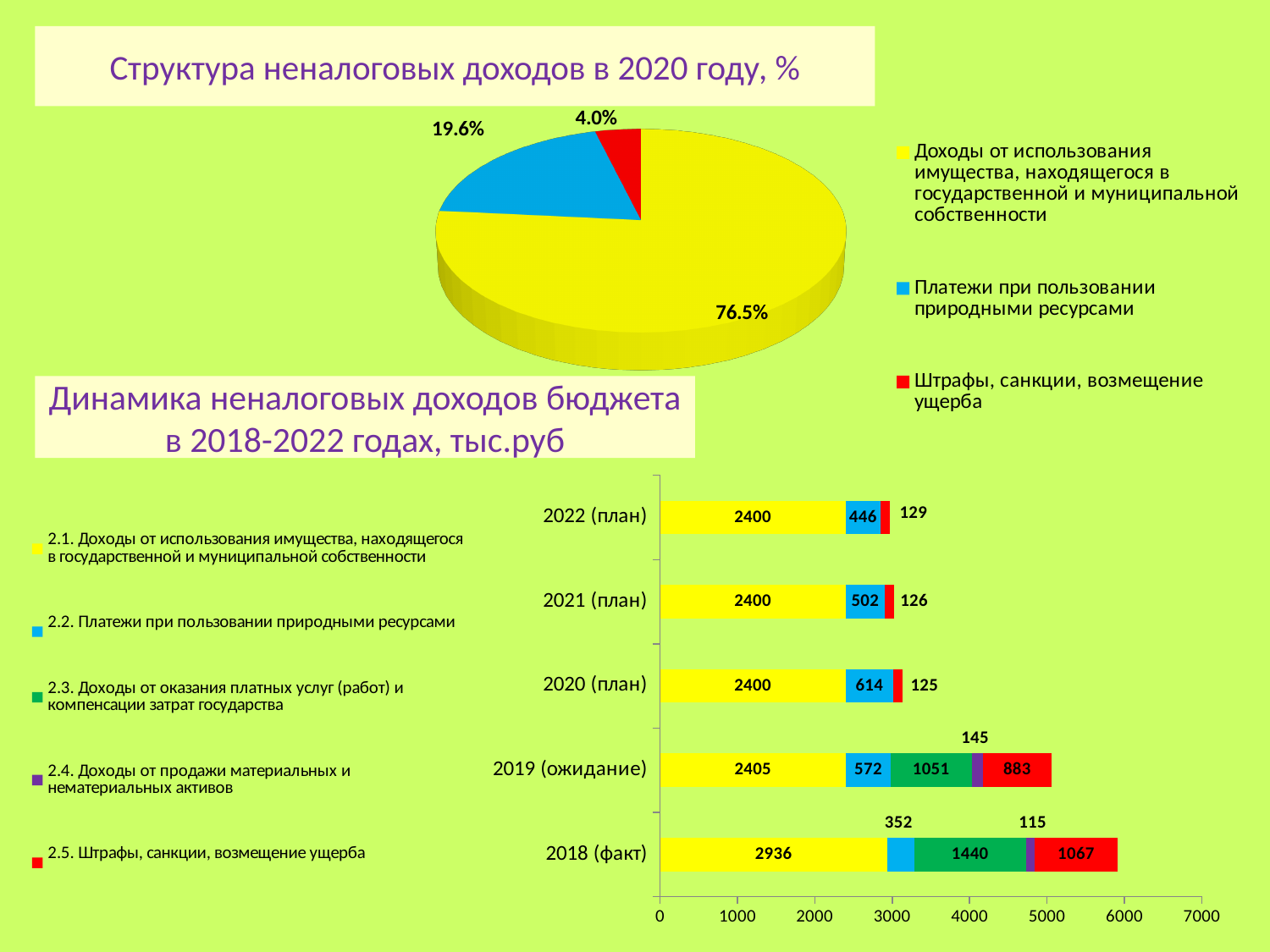
How many series does the legend of the chart 'Динамика неналоговых доходов бюджета в 2018-2022 годах, тыс.руб' list? 5 What kind of chart is 'Динамика неналоговых доходов бюджета в 2018-2022 годах, тыс.руб'? Stacked bar chart In the chart 'Динамика неналоговых доходов бюджета в 2018-2022 годах, тыс.руб', is the value of series 2.5 larger for 2018 (факт) or for 2019 (ожидание)? 2018 (факт) In the pie chart 'Структура неналоговых доходов в 2020 году, %', which category has the largest slice? Доходы от использования имущества, находящегося в государственной и муниципальной собственности In the pie chart 'Структура неналоговых доходов в 2020 году, %', what share is shown for 'Платежи при пользовании природными ресурсами'? 19.6% In the chart 'Динамика неналоговых доходов бюджета в 2018-2022 годах, тыс.руб', what is the value of series 2.1 for 2018 (факт)? 2936 In the pie chart 'Структура неналоговых доходов в 2020 году, %', which category has the smallest slice? Штрафы, санкции, возмещение ущерба In the chart 'Динамика неналоговых доходов бюджета в 2018-2022 годах, тыс.руб', is the total length of the bar for 2018 (факт) greater or less than 5000? greater In the chart 'Динамика неналоговых доходов бюджета в 2018-2022 годах, тыс.руб', what is the value of series 2.3 for 2019 (ожидание)? 1051 How many slices does the pie chart 'Структура неналоговых доходов в 2020 году, %' have? 3 In the chart 'Динамика неналоговых доходов бюджета в 2018-2022 годах, тыс.руб', what is the total of the stacked bar for 2019 (ожидание)? 5056 In the chart 'Динамика неналоговых доходов бюджета в 2018-2022 годах, тыс.руб', what is the difference between the value of series 2.2 for 2020 (план) and for 2022 (план)? 168